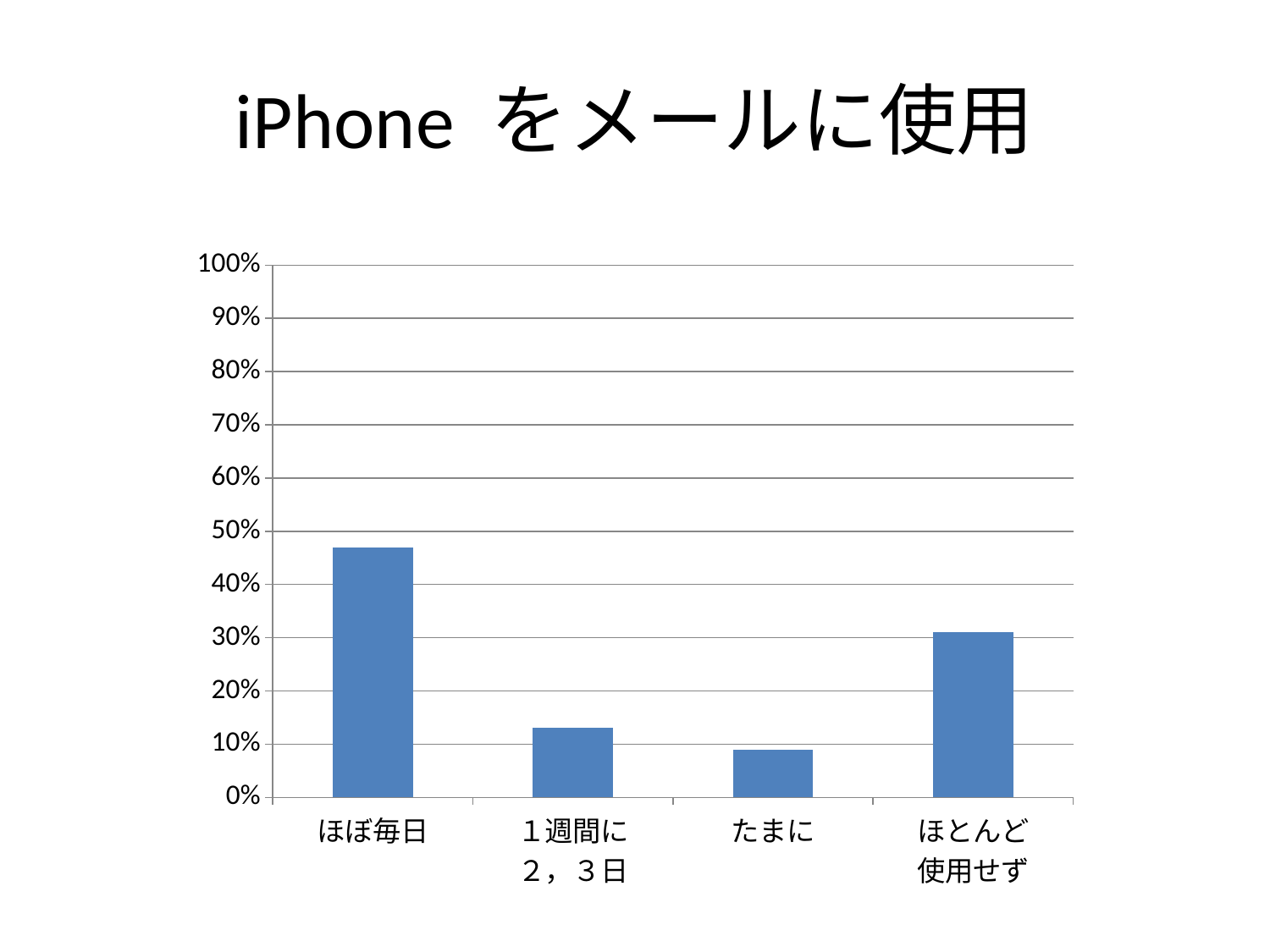
Which category has the lowest bar in the chart? たまに Is the value for ほぼ毎日 greater or less than 50%? less Which is larger, the value for ほとんど使用せず or the value for １週間に２，３日? ほとんど使用せず What kind of chart is shown on the slide? bar chart What is the maximum value shown on the y axis of the chart? 100% How many categories are shown on the x axis of the chart? 4 What is the title of the chart on the slide? iPhone をメールに使用 Which category has the highest bar in the chart? ほぼ毎日 Is the value for １週間に２，３日 greater or less than 20%? less Is the value for ほぼ毎日 greater or less than 40%? greater